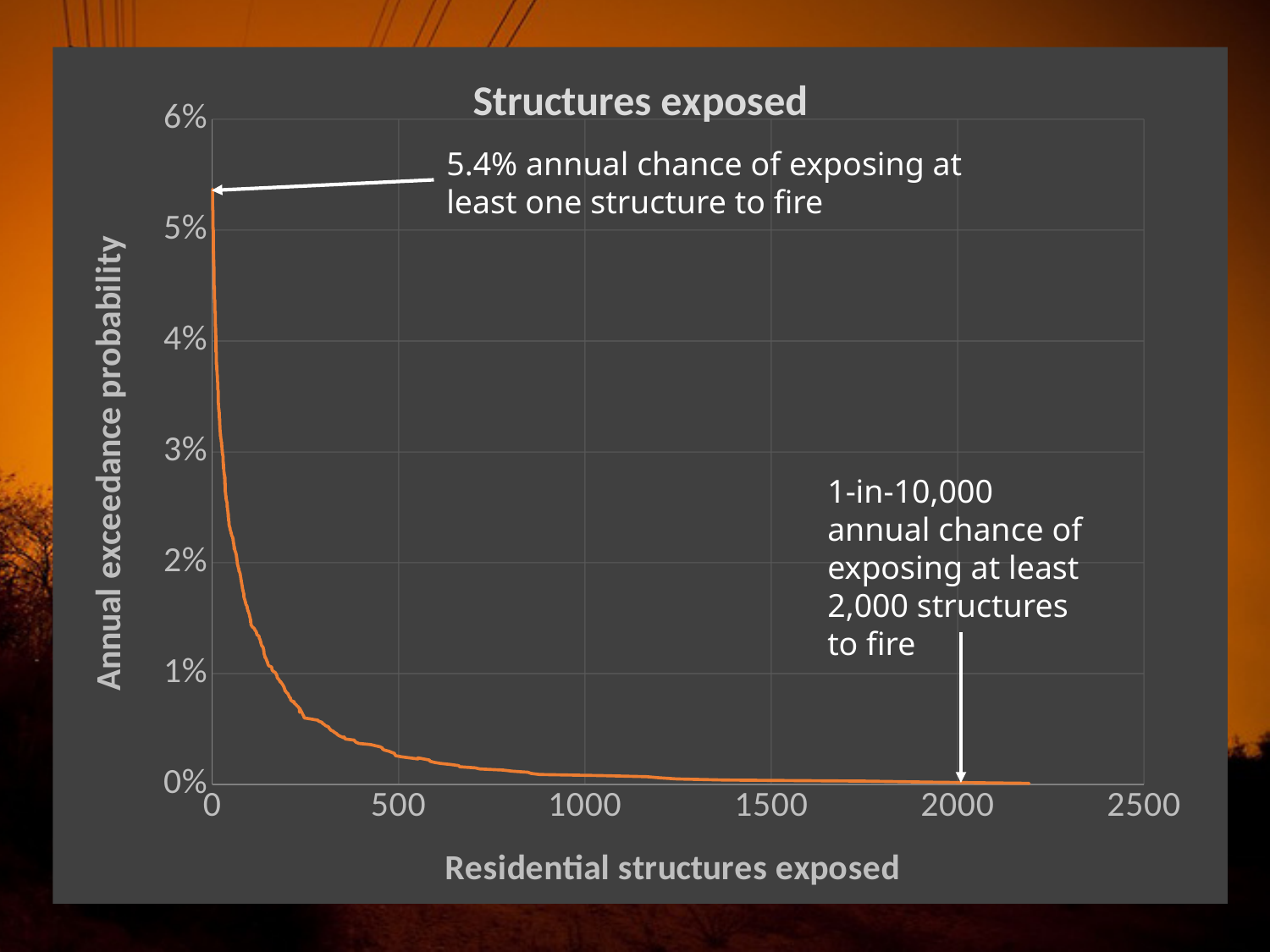
Does the annual exceedance probability rise or fall as the number of residential structures exposed increases? fall What kind of chart is shown on the slide? line chart Is the annual exceedance probability at 100 residential structures exposed greater or less than 3%? less According to the annotation, what is the annual chance of exposing at least one structure to fire? 5.4% What is the title of the chart? Structures exposed Is the annual exceedance probability at 1000 residential structures exposed greater or less than 1%? less According to the annotation, what is the annual chance of exposing at least 2,000 structures to fire? 1-in-10,000 Which has the higher annual exceedance probability: 500 or 2000 residential structures exposed? 500 Is the annual exceedance probability at the start of the curve (near 0 structures) greater or less than 5%? greater What is the highest value shown on the y axis? 6% What is the label of the x axis? Residential structures exposed